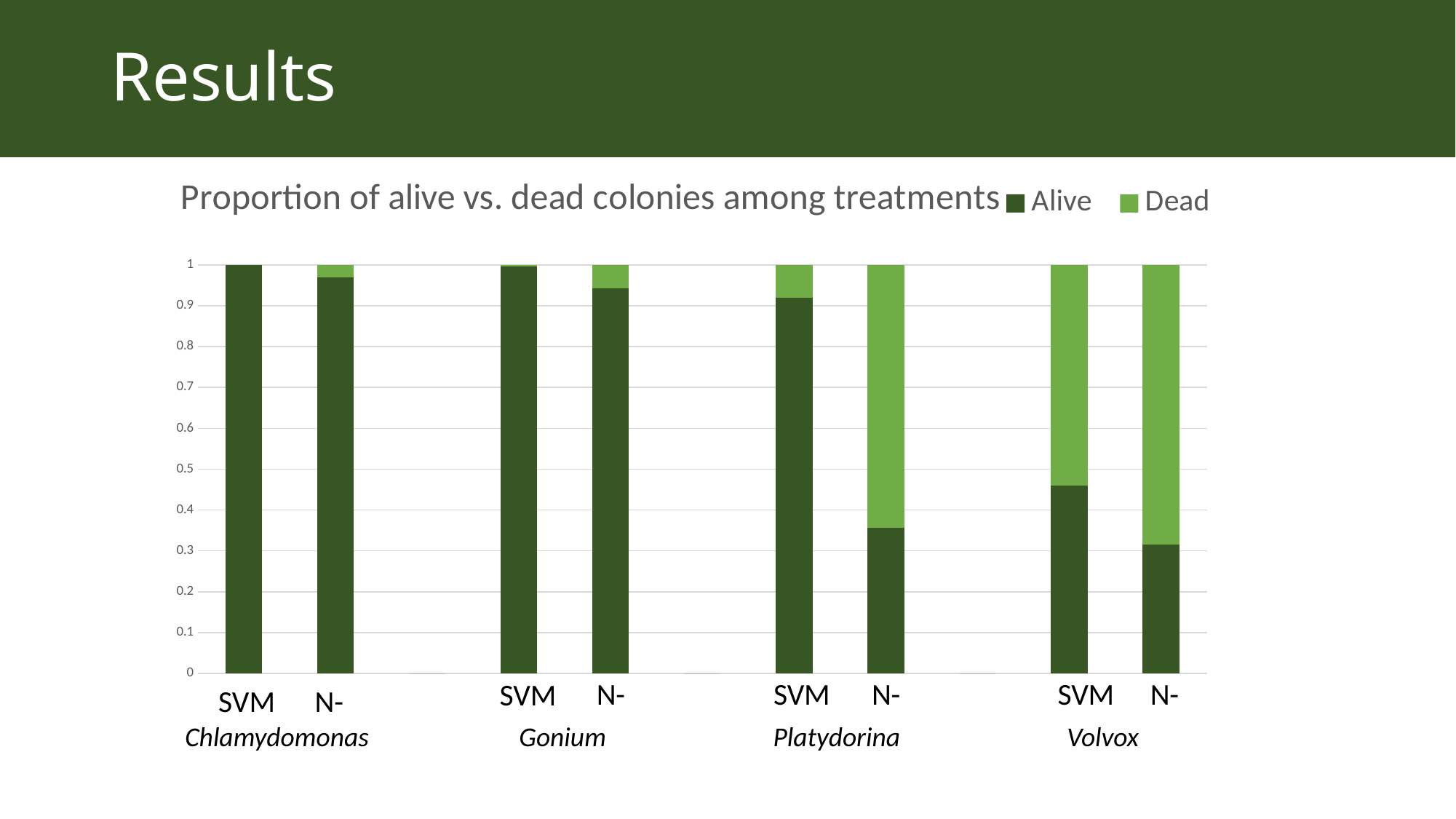
Is the Alive proportion for Volvox SVM greater or less than 0.5? less How many bars are plotted in the chart? 8 How many species groups are shown along the x axis? 4 What kind of chart is shown on the slide? Stacked bar chart Which series is shown in the lighter green colour? Dead Which bar has the lowest Alive proportion? Volvox N- Is the Alive proportion for Platydorina SVM greater or less than 0.9? greater Is the Alive proportion for Volvox N- greater or less than 0.4? less How many series does the legend list? 2 What is the title of the chart? Proportion of alive vs. dead colonies among treatments Which has the larger Alive proportion, Volvox SVM or Volvox N-? Volvox SVM